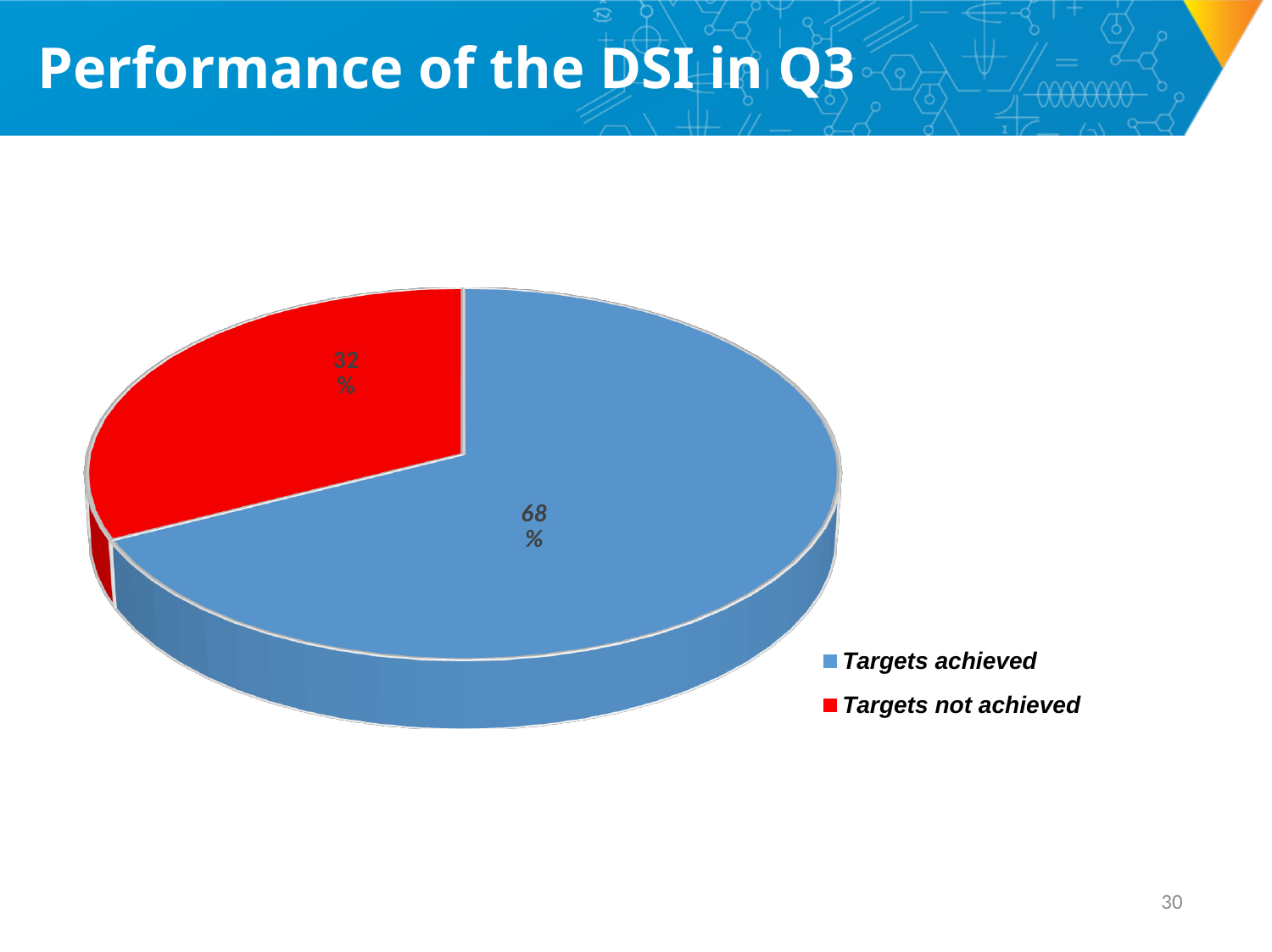
What share of the pie is labelled "Targets not achieved"? 32% How many slices does the pie chart have? 2 Which is larger, the "Targets achieved" slice or the "Targets not achieved" slice? Targets achieved Which slice is the largest? Targets achieved How many entries does the legend list? 2 Which slice is the smallest? Targets not achieved What is the title of the slide containing the chart? Performance of the DSI in Q3 What is the difference in percentage points between the "Targets achieved" and "Targets not achieved" slices? 36 What colour is the "Targets not achieved" slice? red What kind of chart is shown on the slide? pie chart What share of the pie is labelled "Targets achieved"? 68%